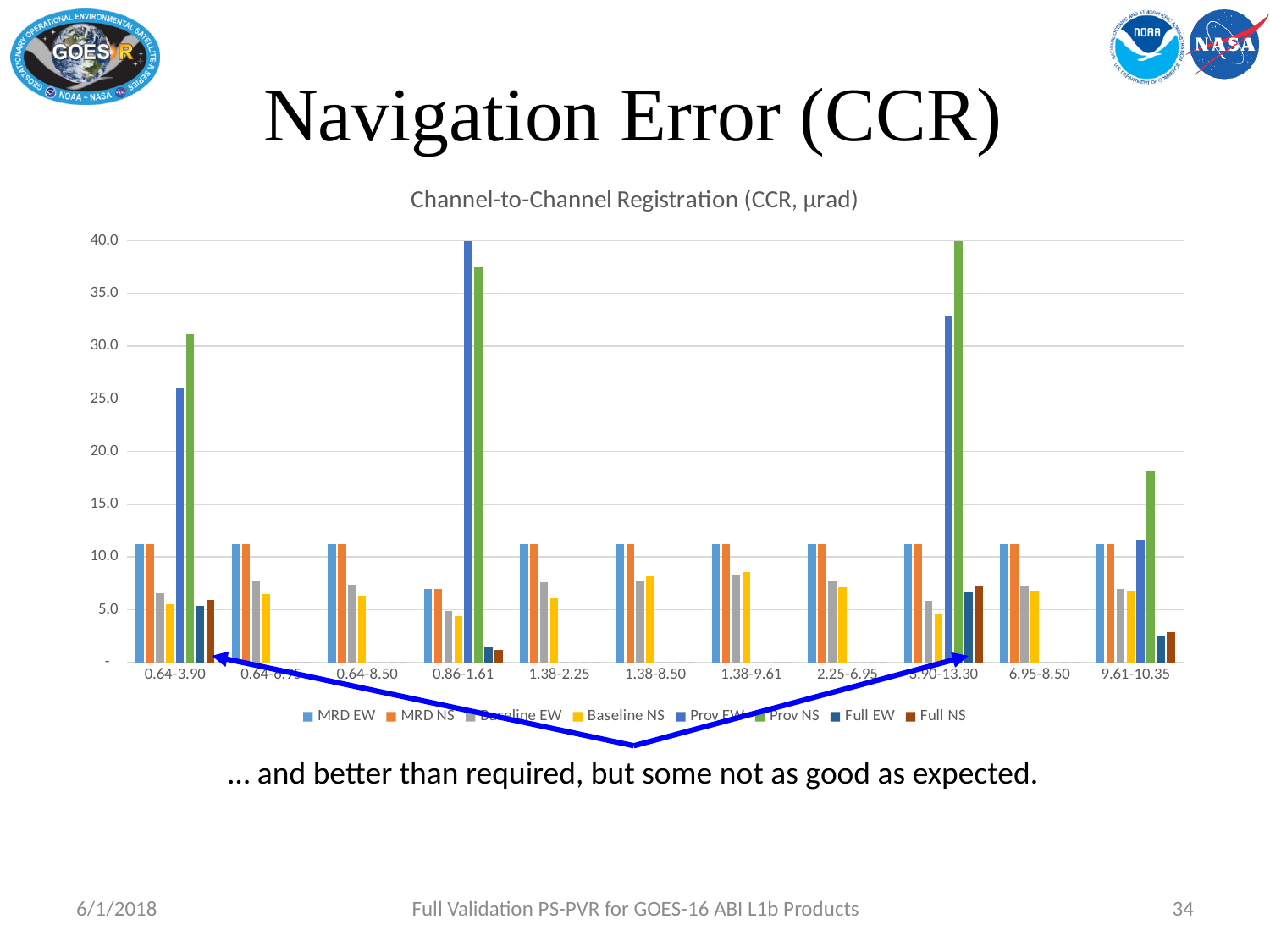
Which series is shown in green in the legend? Prov NS Is the Full NS value for 0.86-1.61 greater or less than 5.0? less How many channel-pair categories are shown on the x axis? 11 What is the title of the chart? Channel-to-Channel Registration (CCR, μrad) Is the Prov EW value for 0.64-3.90 greater or less than 20.0? greater Is the Prov NS value for 9.61-10.35 greater or less than 15.0? greater For 0.64-3.90, which is larger: the Prov NS value or the Prov EW value? Prov NS Which category has the highest Prov EW value? 0.86-1.61 How many series does the chart legend list? 8 What kind of chart is shown on the slide? Bar chart